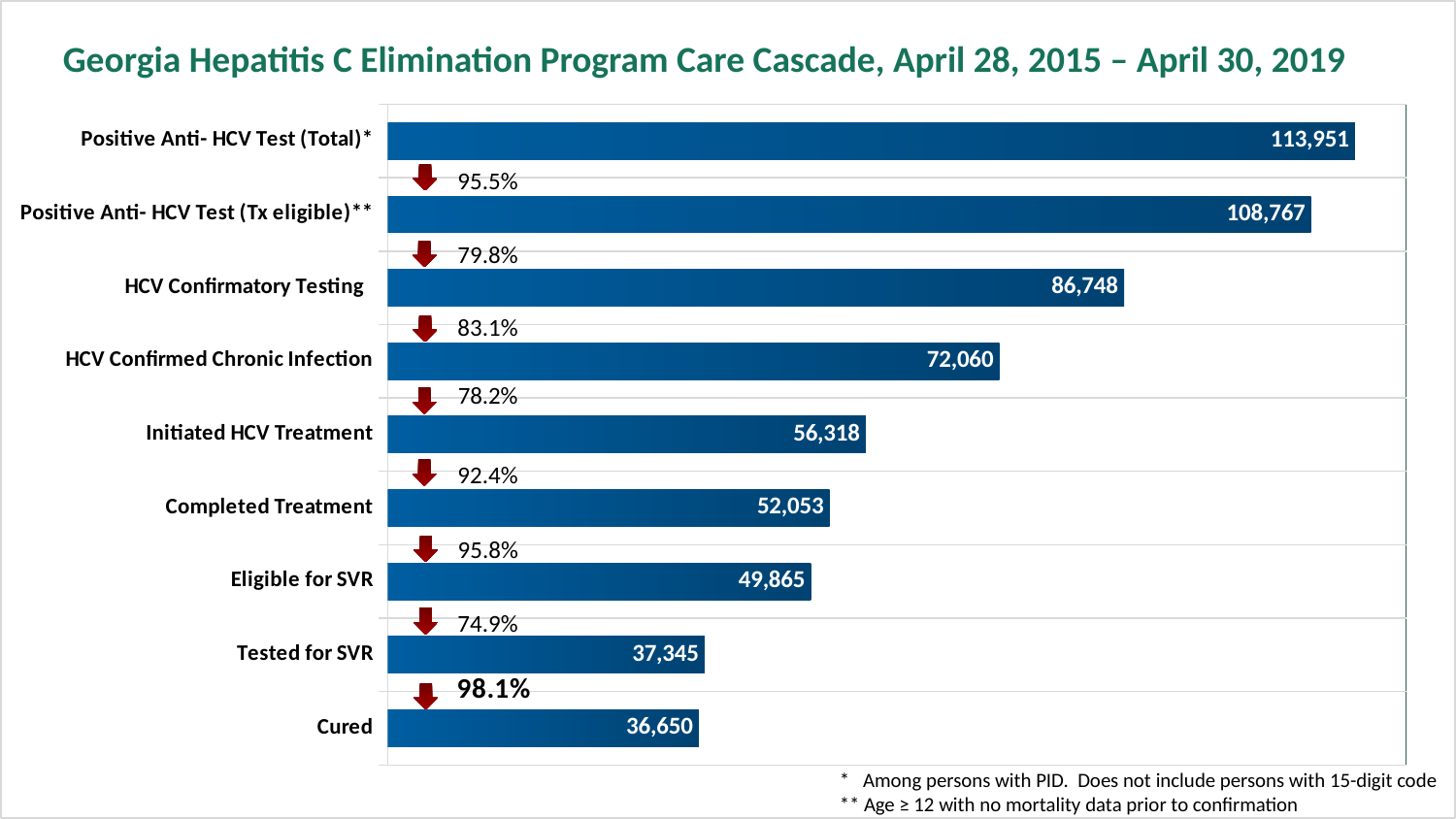
What is the value for HCV Confirmatory Testing? 86,748 What is the difference between Tested for SVR and Cured? 695 Which is larger, HCV Confirmed Chronic Infection or Initiated HCV Treatment? HCV Confirmed Chronic Infection What is the value for Positive Anti- HCV Test (Total)*? 113,951 What kind of chart is this? Bar chart What percentage is shown between Tested for SVR and Cured? 98.1% What is the value for Initiated HCV Treatment? 56,318 How many categories are shown in the chart? 9 Which category has the highest value? Positive Anti- HCV Test (Total)* Which category has the lowest value? Cured What is the value for Cured? 36,650 What is the difference between Completed Treatment and Eligible for SVR? 2,188